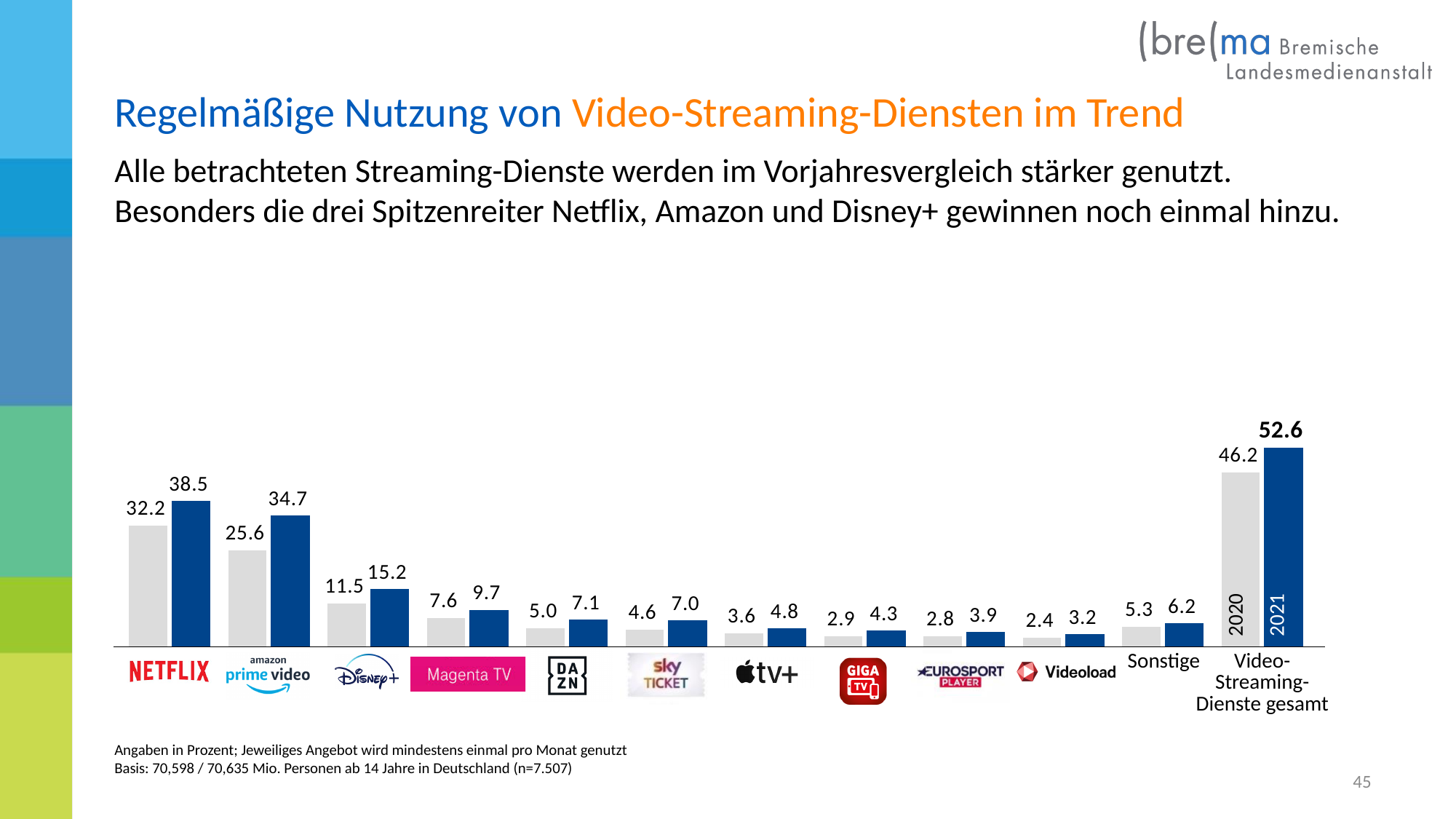
What is the 2021 value for Netflix? 38.5 What is the 2020 value for Video-Streaming-Dienste gesamt? 46.2 Which individual streaming service (excluding the 'gesamt' total) has the highest 2021 value? Netflix How many series (years) does the chart compare? 2 What is the difference between the 2021 values for Amazon Prime Video and Disney+? 19.5 By how much did the Netflix value increase from 2020 to 2021? 6.3 What kind of chart is shown on the slide? Bar chart Which category has the lowest 2020 value? Videoload What is the 2020 value for Amazon Prime Video? 25.6 Which is larger: the 2021 value for DAZN or the 2021 value for Sky Ticket? DAZN What is the 2021 value for Disney+? 15.2 How many categories are shown on the x axis? 12